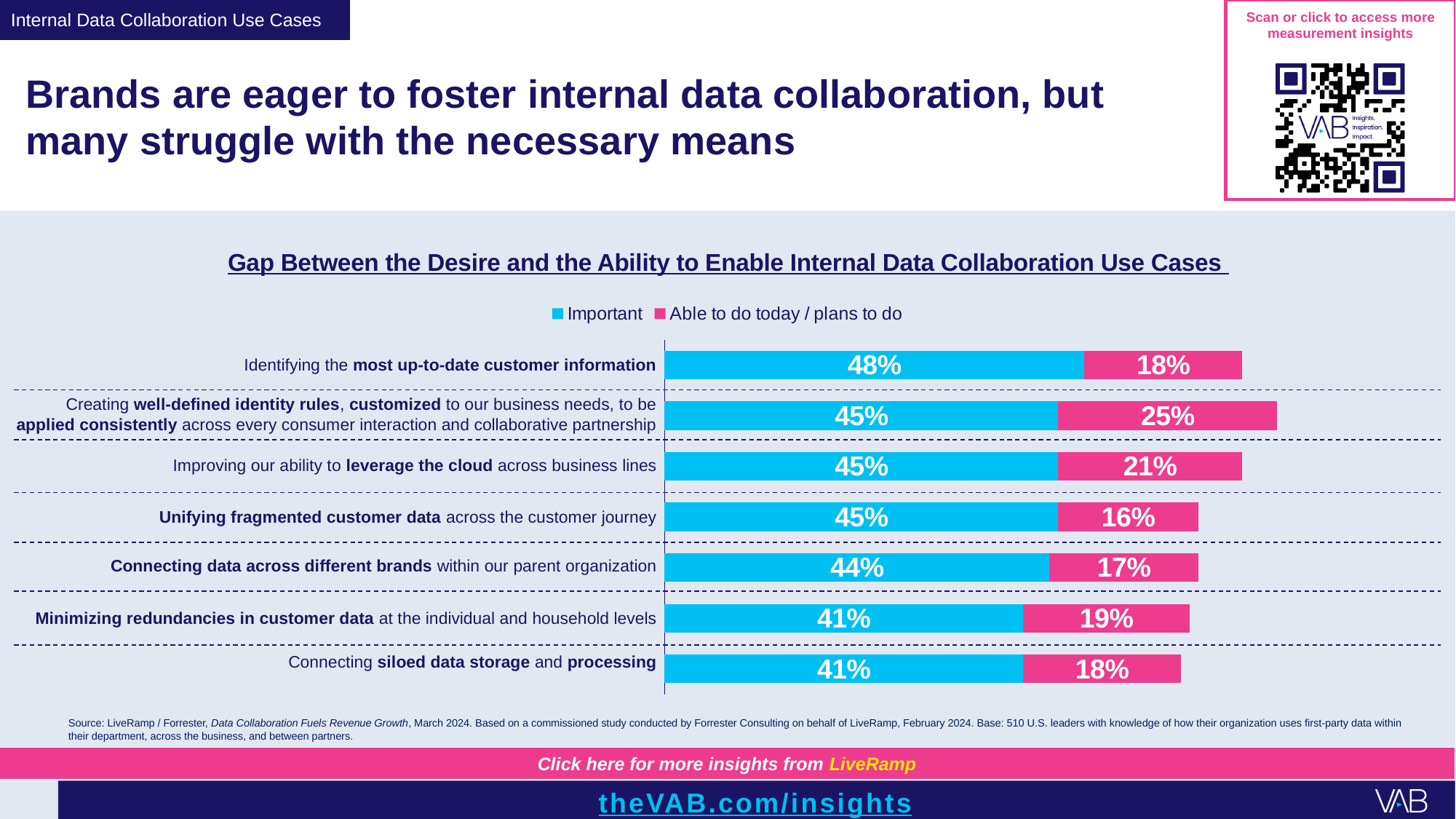
What kind of chart is shown on the slide? Stacked bar chart What is the 'Able to do today / plans to do' value for 'Unifying fragmented customer data across the customer journey'? 16% Which use case has the highest 'Important' value? Identifying the most up-to-date customer information How many use cases are shown in the chart? 7 How many series does the legend list? 2 What is the 'Able to do today / plans to do' value for 'Creating well-defined identity rules, customized to our business needs, to be applied consistently across every consumer interaction and collaborative partnership'? 25% What is the total of the stacked bar for 'Minimizing redundancies in customer data at the individual and household levels'? 60% What is the title of the chart? Gap Between the Desire and the Ability to Enable Internal Data Collaboration Use Cases Which use case has the lowest 'Able to do today / plans to do' value? Unifying fragmented customer data across the customer journey What is the 'Important' value for 'Identifying the most up-to-date customer information'? 48% What is the difference between the 'Important' and 'Able to do today / plans to do' values for 'Identifying the most up-to-date customer information'? 30% Which is larger: the 'Able to do today / plans to do' value for 'Improving our ability to leverage the cloud across business lines' or for 'Connecting data across different brands within our parent organization'? Improving our ability to leverage the cloud across business lines